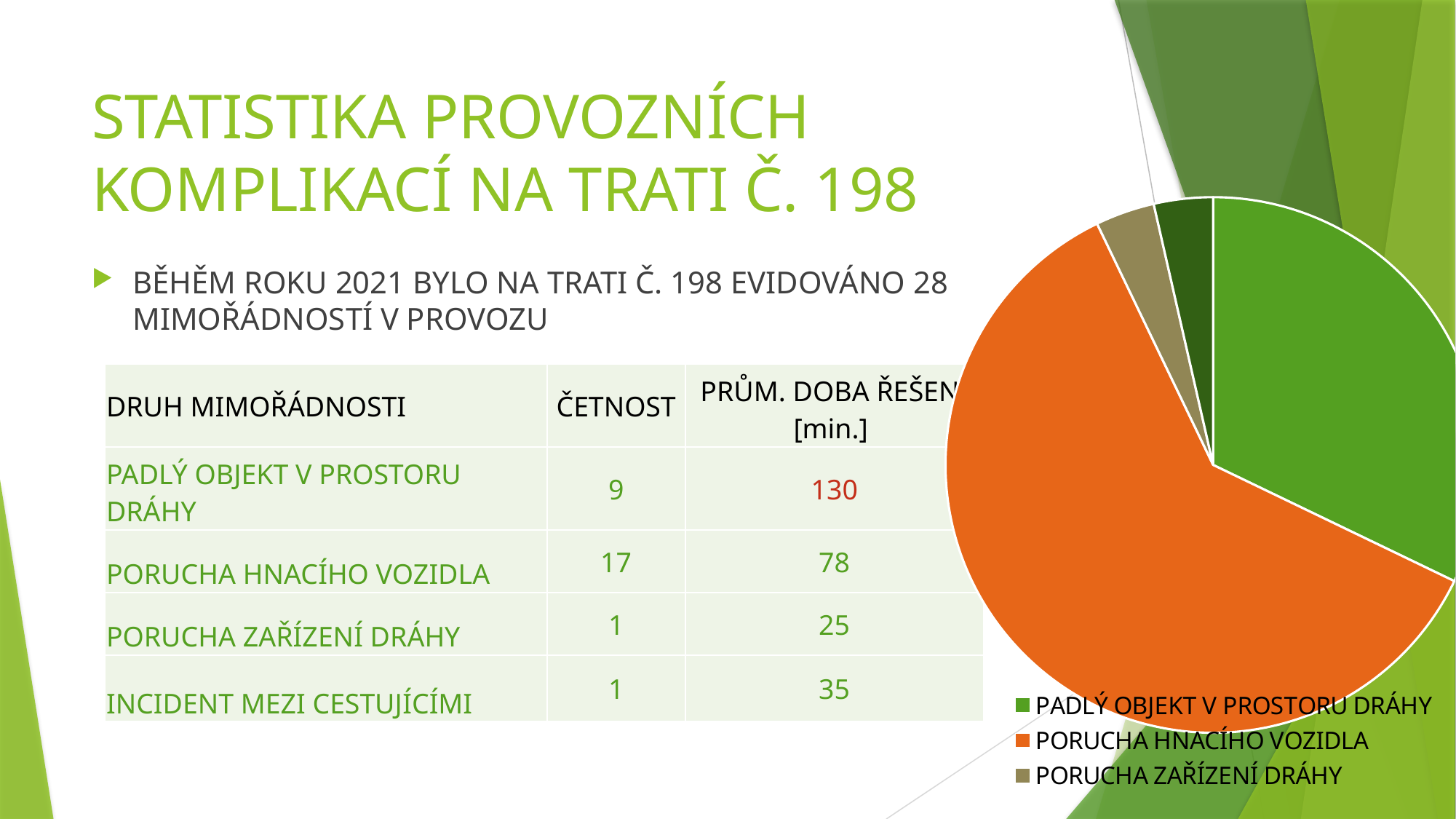
How many entries does the pie chart's legend list? 3 What kind of chart is shown on the slide? pie chart Which category has the largest slice in the pie chart? PORUCHA HNACÍHO VOZIDLA How many slices does the pie chart have? 4 Which slice is larger in the pie chart: PADLÝ OBJEKT V PROSTORU DRÁHY or PORUCHA ZAŘÍZENÍ DRÁHY? PADLÝ OBJEKT V PROSTORU DRÁHY Which slice is larger in the pie chart: PADLÝ OBJEKT V PROSTORU DRÁHY or PORUCHA HNACÍHO VOZIDLA? PORUCHA HNACÍHO VOZIDLA Is the slice for PORUCHA HNACÍHO VOZIDLA more or less than half of the pie? more Which legend entry is shown in green in the pie chart? PADLÝ OBJEKT V PROSTORU DRÁHY What colour is the slice for PORUCHA HNACÍHO VOZIDLA in the pie chart? orange Is the slice for PADLÝ OBJEKT V PROSTORU DRÁHY more or less than half of the pie? less